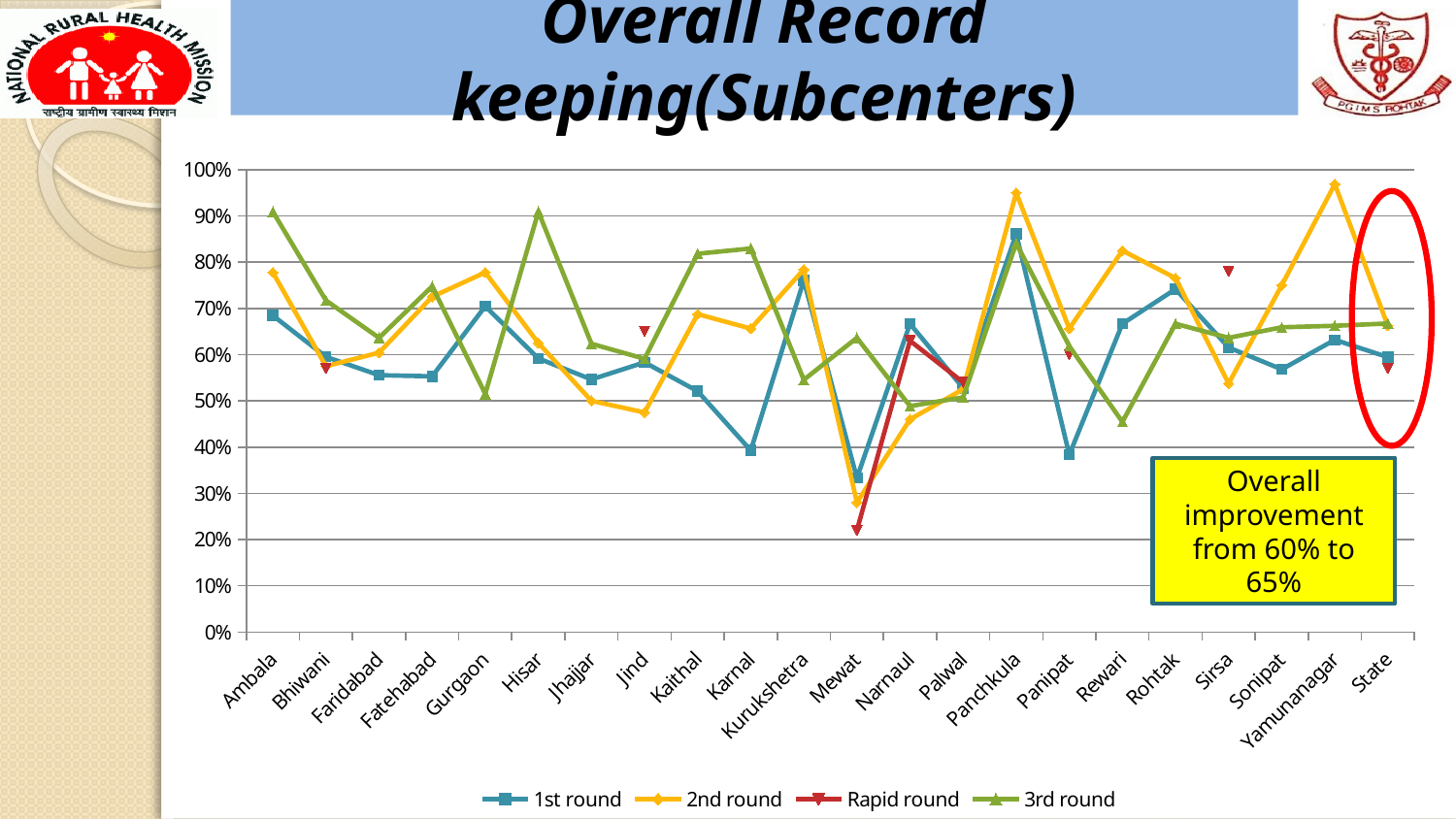
Is the 2nd round value for Yamunanagar greater or less than 90%? greater What kind of chart is shown on the slide? Line chart What is the title of the chart? Overall Record keeping(Subcenters) Which category has the lowest value for the 1st round series? Mewat For State, which is larger: the 1st round value or the 2nd round value? 2nd round How many series does the legend list? 4 Which category has the highest value for the 1st round series? Panchkula Which category has the lowest value for the 2nd round series? Mewat Is the Rapid round value for Mewat greater or less than 30%? less For Ambala, which is larger: the 1st round value or the 3rd round value? 3rd round How many categories are shown on the x axis? 22 Is the 1st round value for Karnal greater or less than 50%? less